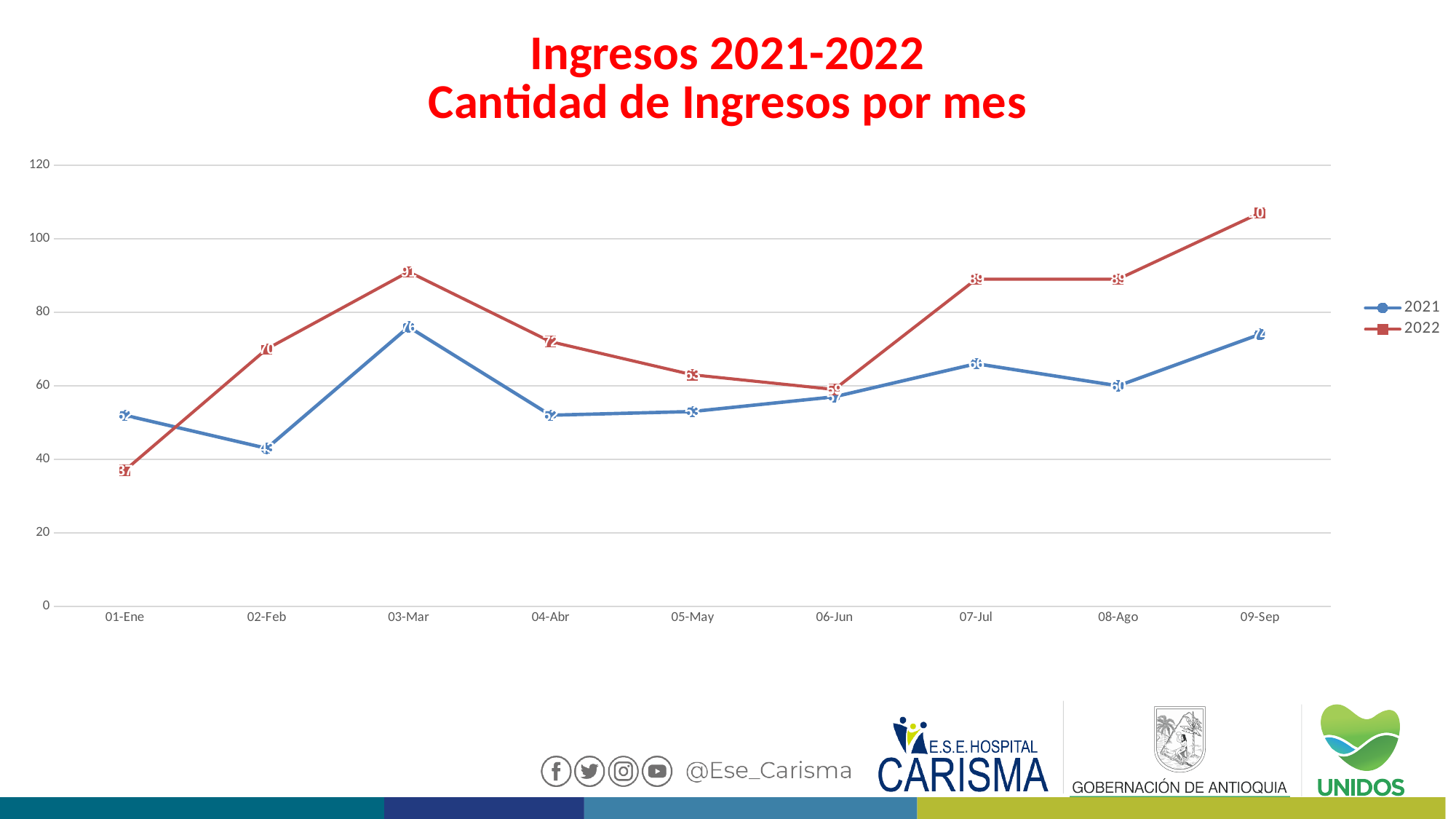
In 03-Mar, which series has the larger value, 2021 or 2022? 2022 Is the value for 2022 in 09-Sep greater or less than 100? greater In which month does the 2022 series have its lowest value? 01-Ene In which month does the 2021 series reach its highest value? 03-Mar In which month does the 2022 series reach its highest value? 09-Sep What kind of chart is shown on the slide? Line chart What is the value for 2022 in 03-Mar? 91 How many series does the legend list? 2 What is the difference between the 2022 value and the 2021 value in 07-Jul? 23 How many months are plotted along the x axis? 9 What is the value for 2022 in 08-Ago? 89 What is the value for 2021 in 07-Jul? 66